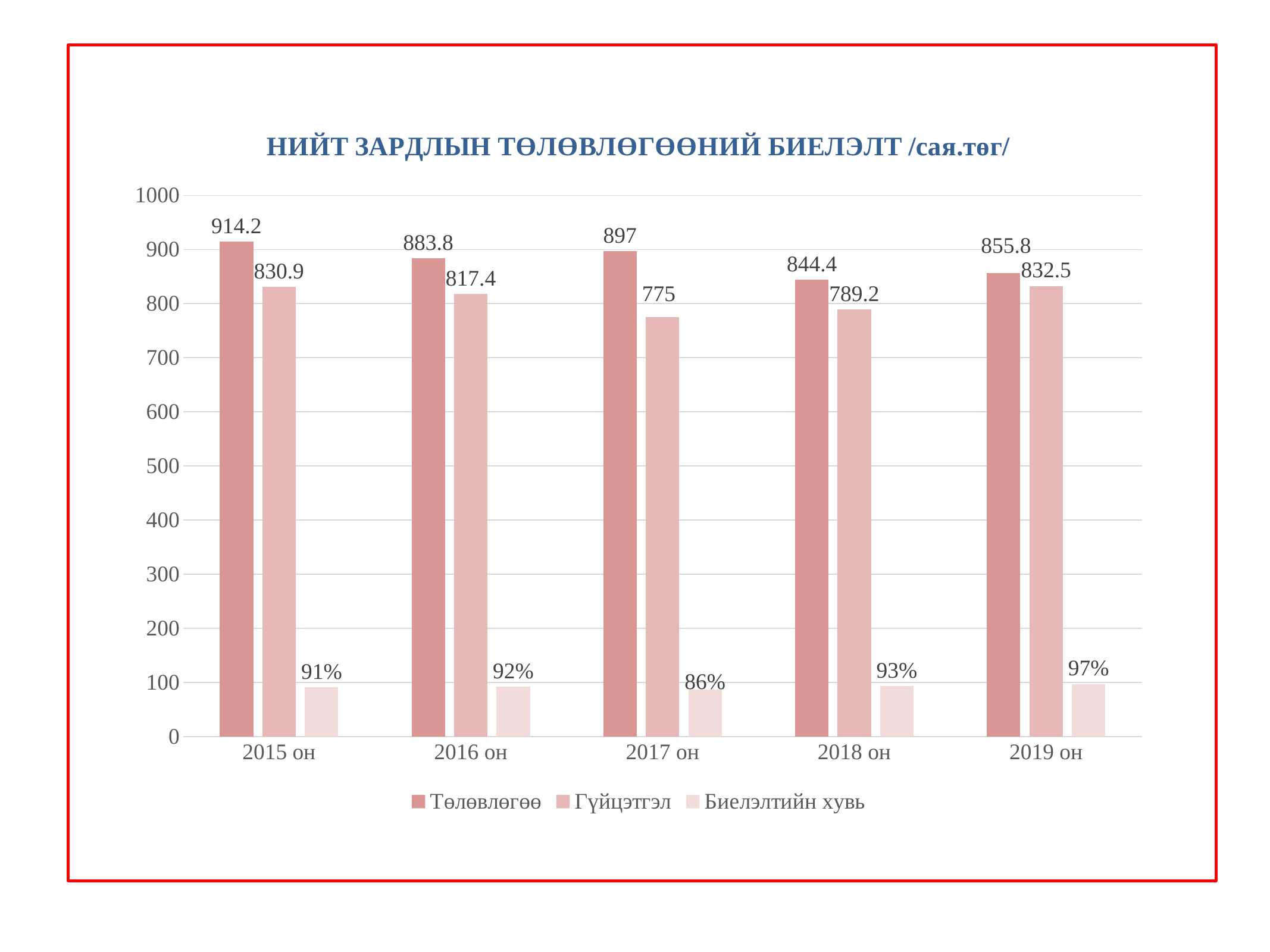
Which year has the highest Биелэлтийн хувь value? 2019 он How many years are shown on the x axis? 5 What is the Гүйцэтгэл value for 2019 он? 832.5 What is the title of the chart? НИЙТ ЗАРДЛЫН ТӨЛӨВЛӨГӨӨНИЙ БИЕЛЭЛТ /сая.төг/ What kind of chart is shown on the slide? Bar chart How many series does the legend list? 3 Which year has the lowest Гүйцэтгэл value? 2017 он What is the difference between the Төлөвлөгөө and Гүйцэтгэл values for 2015 он? 83.3 Which is larger, the Гүйцэтгэл value for 2016 он or for 2018 он? 2016 он What is the Төлөвлөгөө value for 2017 он? 897 What is the Биелэлтийн хувь value for 2018 он? 93% Which year has the highest Төлөвлөгөө value? 2015 он